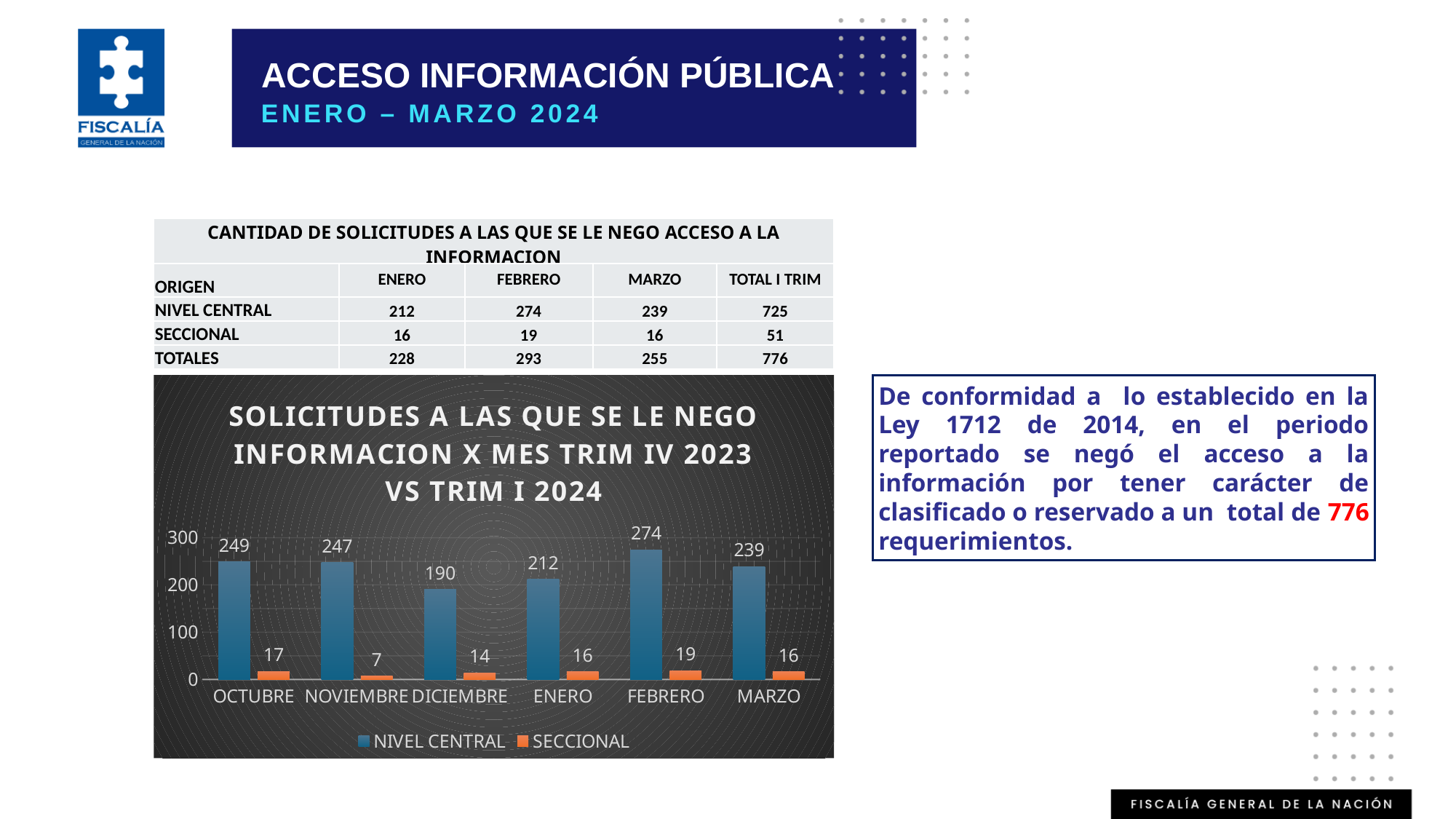
What is the NIVEL CENTRAL value for FEBRERO? 274 Which is larger, the SECCIONAL value for OCTUBRE or for MARZO? OCTUBRE What is the SECCIONAL value for NOVIEMBRE? 7 Which month has the highest NIVEL CENTRAL value? FEBRERO Which series is shown in orange in the chart? SECCIONAL How many months are shown on the x axis of the chart? 6 What kind of chart is shown on the slide? Bar chart How many series does the chart legend list? 2 Which month has the lowest SECCIONAL value? NOVIEMBRE What is the NIVEL CENTRAL value for OCTUBRE? 249 What is the difference between the NIVEL CENTRAL values for FEBRERO and DICIEMBRE? 84 Which month has the lowest NIVEL CENTRAL value? DICIEMBRE